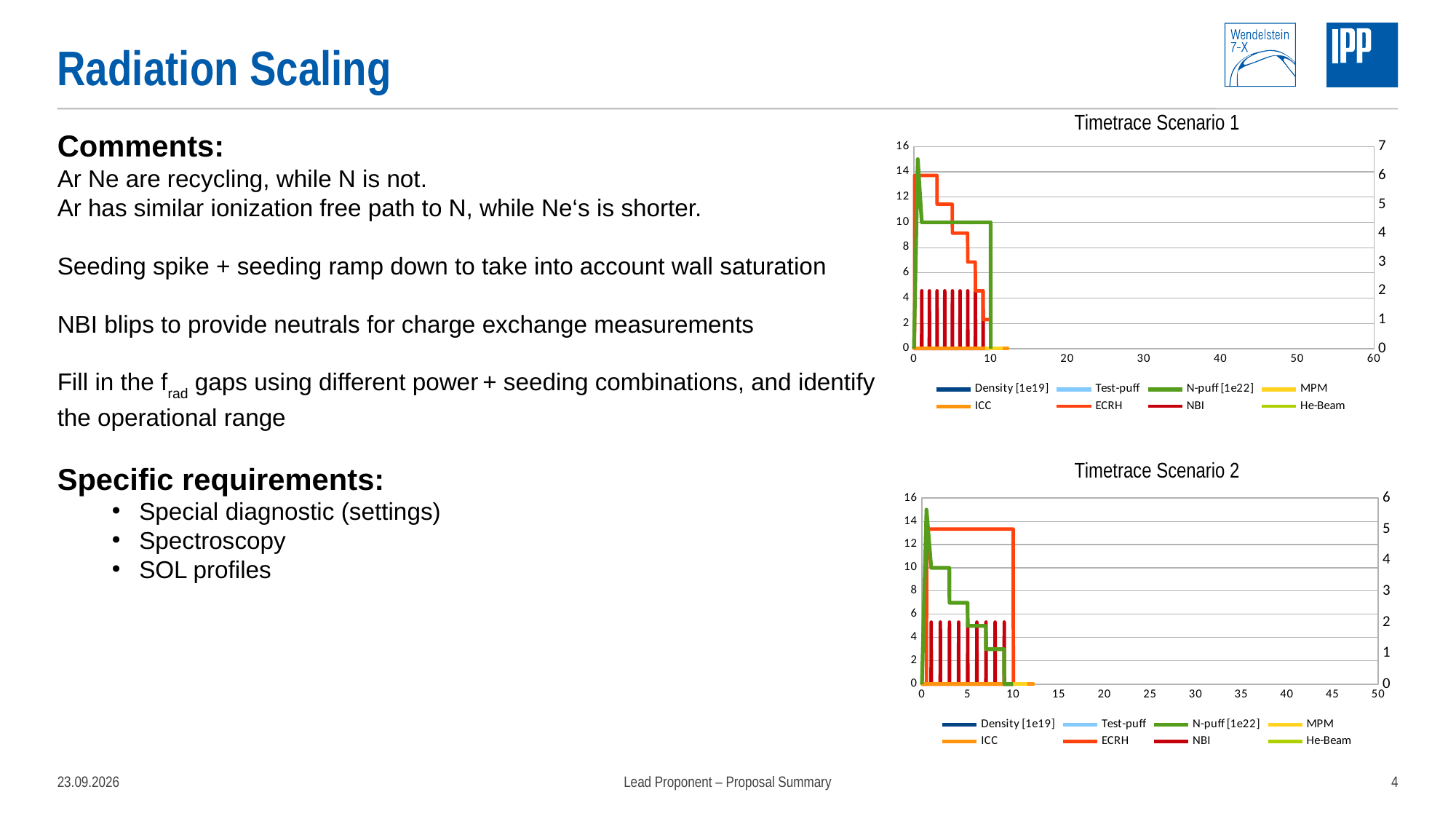
In the Timetrace Scenario 2 chart, is the plateau value of the ECRH series on the left axis greater or less than 12? greater How many series does the legend of the Timetrace Scenario 1 chart list? 8 In the Timetrace Scenario 1 chart, does the ECRH series rise or fall along the x axis after its initial plateau? fall How many series does the legend of the Timetrace Scenario 2 chart list? 8 What kind of chart is the Timetrace Scenario 2 chart? line chart In the Timetrace Scenario 2 chart, is the peak of the N-puff [1e22] series on the left axis greater or less than 14? greater In the Timetrace Scenario 2 chart, does the N-puff [1e22] series rise or fall along the x axis after its initial spike? fall In the Timetrace Scenario 1 chart, is the peak of the NBI blips on the left axis greater or less than 6? less In the Timetrace Scenario 2 chart, which series is drawn in green? N-puff [1e22] What is the title of the upper chart on the slide? Timetrace Scenario 1 What kind of chart is the Timetrace Scenario 1 chart? line chart What is the maximum value shown on the x axis of the Timetrace Scenario 2 chart? 50